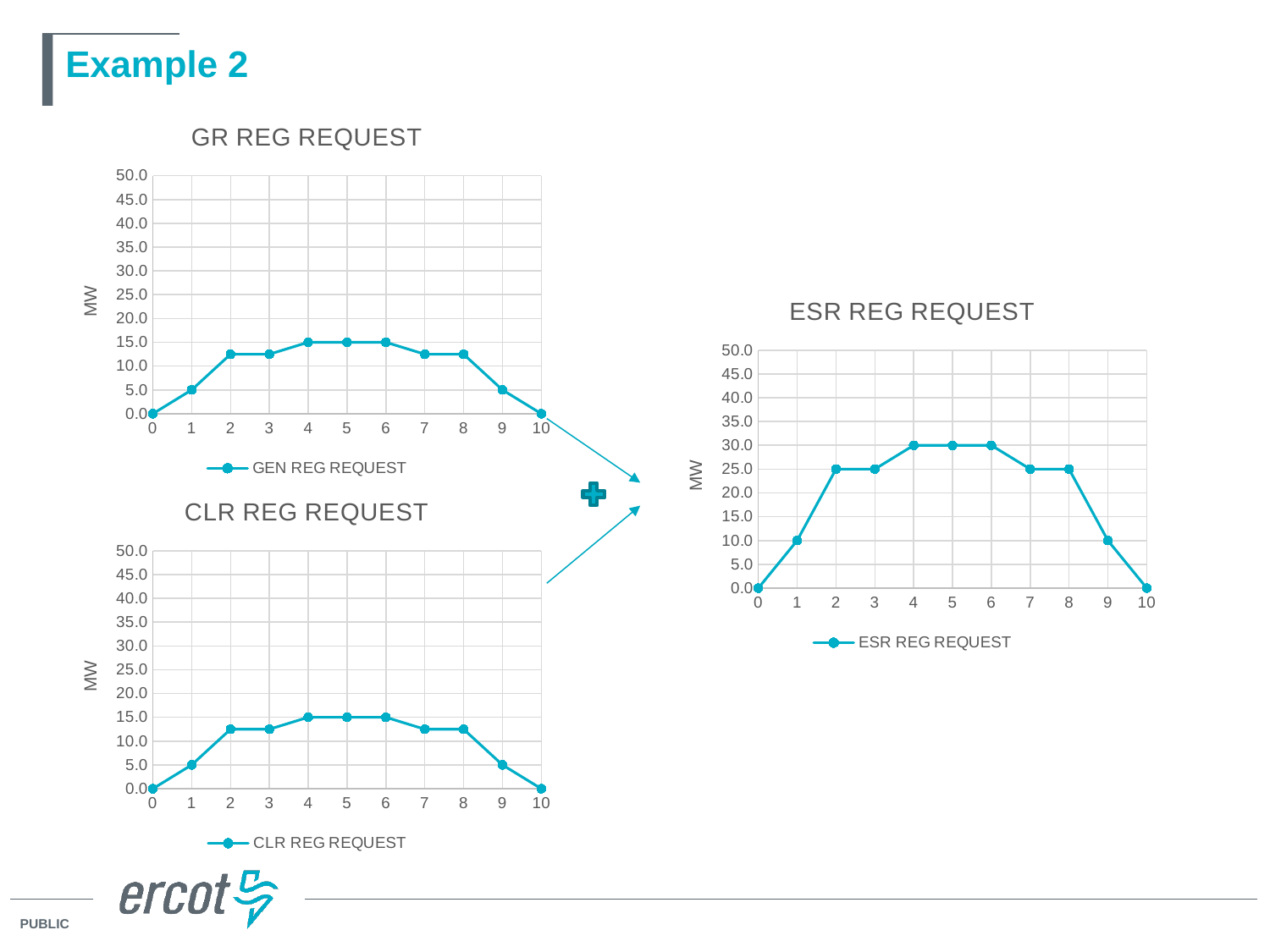
In the ESR REG REQUEST chart, what is the value at x = 1? 10.0 In the GR REG REQUEST chart, what is the value at x = 4? 15.0 In the GR REG REQUEST chart, what kind of chart is shown? line chart In the GR REG REQUEST chart, how many data points are plotted? 11 In the CLR REG REQUEST chart, how many series does the legend list? 1 In the ESR REG REQUEST chart, what is the label on the y axis? MW In the CLR REG REQUEST chart, what is the value at x = 5? 15.0 Which is larger: the value at x = 4 in the ESR REG REQUEST chart or the value at x = 4 in the GR REG REQUEST chart? ESR REG REQUEST In the CLR REG REQUEST chart, is the value at x = 7 greater or less than 15.0? less In the GR REG REQUEST chart, is the value at x = 2 greater or less than 10.0? greater In the ESR REG REQUEST chart, what is the value at x = 4? 30.0 In the GR REG REQUEST chart, what is the value at x = 1? 5.0